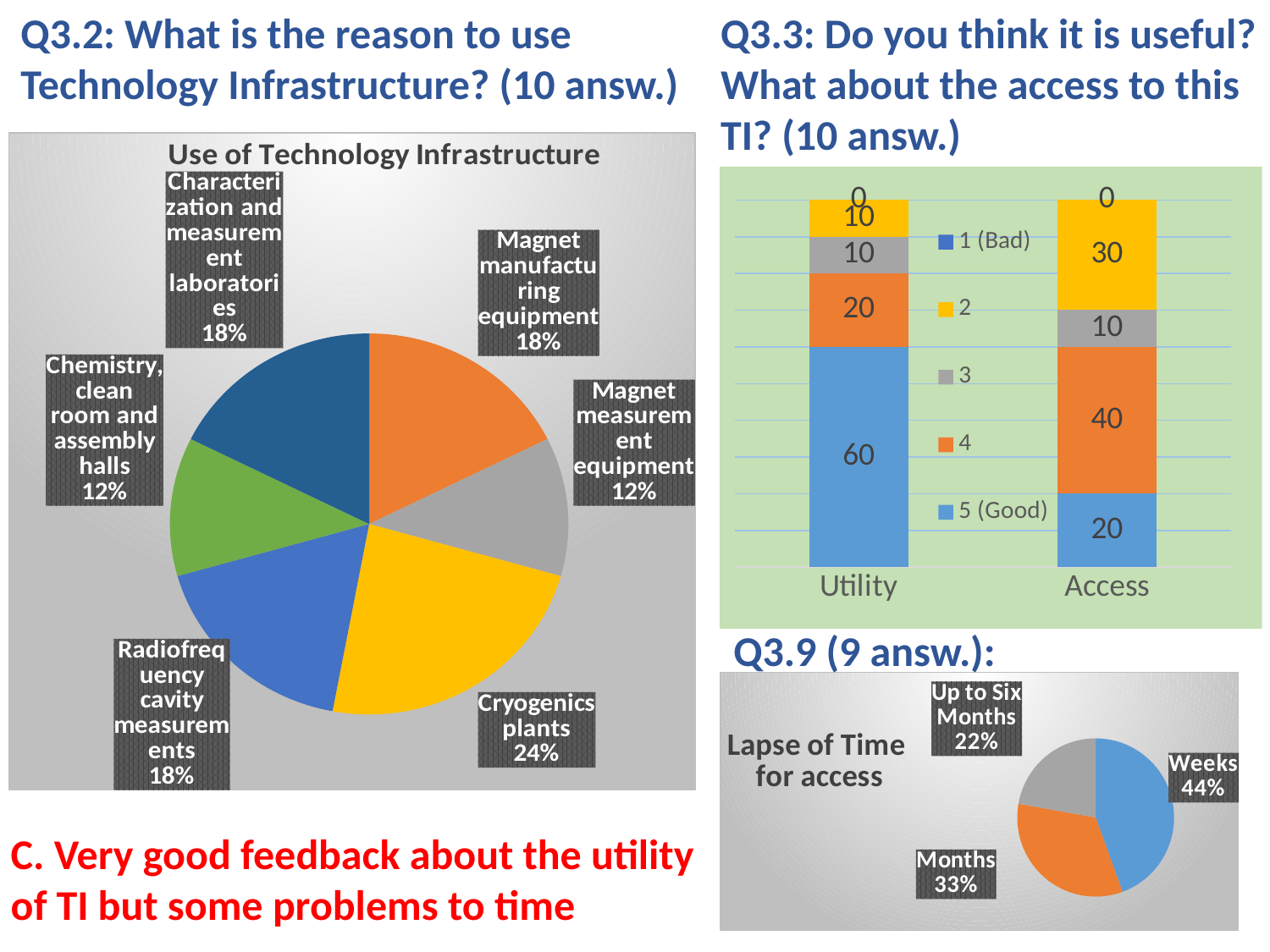
In the 'Use of Technology Infrastructure' pie chart, what is the difference between the share for Cryogenics plants and the share for Magnet measurement equipment? 12% In the stacked bar chart for Q3.3, what is the value of '4' for Access? 40 In the stacked bar chart for Q3.3, which is larger: the '2' value for Utility or the '2' value for Access? Access In the stacked bar chart for Q3.3, what is the value of '5 (Good)' for Utility? 60 In the 'Use of Technology Infrastructure' pie chart, which category has the largest share? Cryogenics plants In the stacked bar chart for Q3.3, what is the total of the Access bar? 100 What kind of chart is used for Q3.3 (Utility and Access)? Stacked bar chart In the stacked bar chart for Q3.3, how many series does the legend list? 5 In the 'Lapse of Time for access' pie chart, what share does Weeks have? 44% In the 'Use of Technology Infrastructure' pie chart, what share does Cryogenics plants have? 24% How many categories are shown in the 'Use of Technology Infrastructure' pie chart? 6 In the 'Lapse of Time for access' pie chart, which category has the smallest share? Up to Six Months